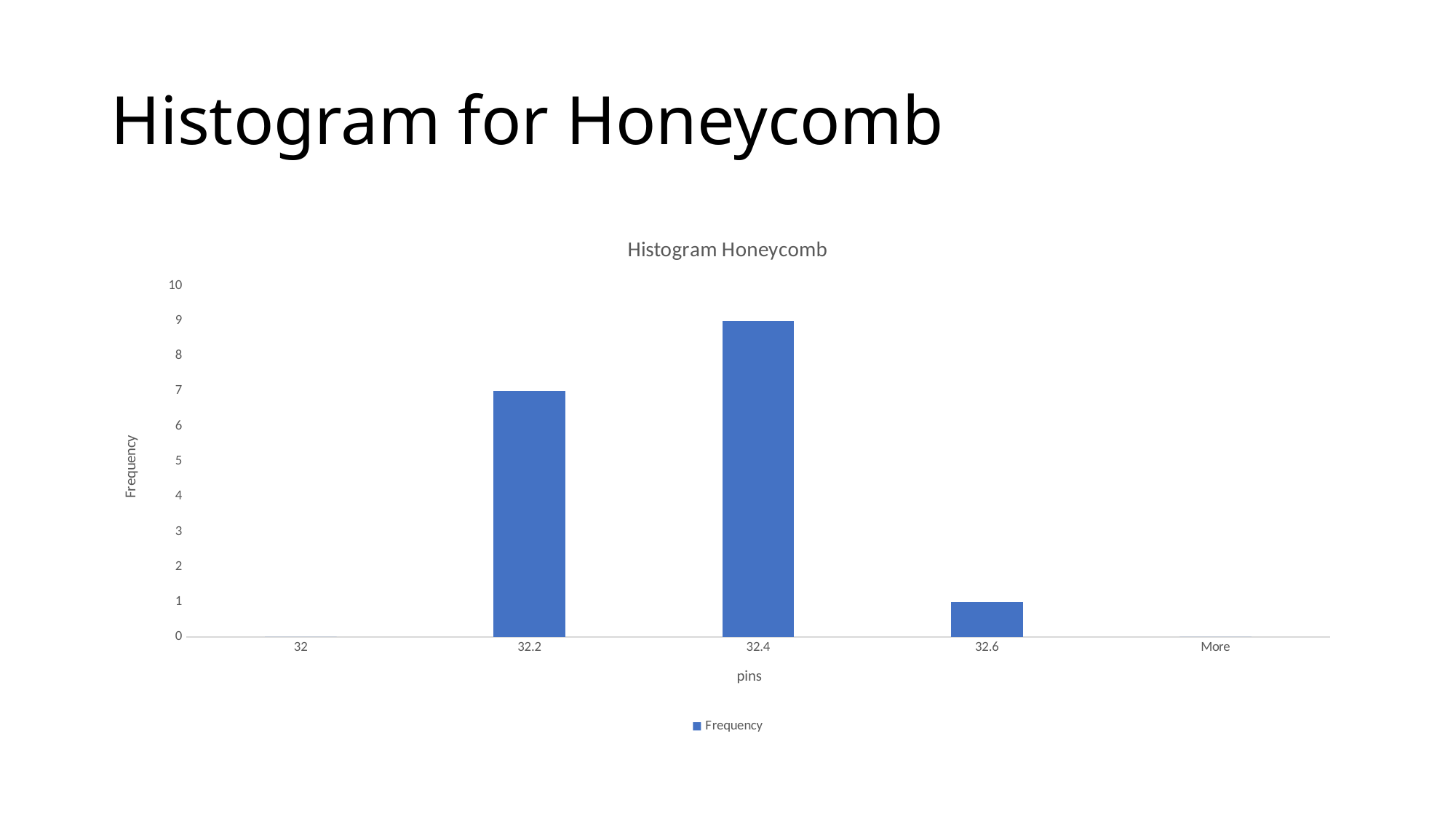
Which bin has a larger frequency, 32.2 or 32.6? 32.2 What is the frequency for the 32.6 bin? 1 Is the frequency for the 32.4 bin greater or less than 5? greater What is the difference in frequency between the 32.4 bin and the 32.2 bin? 2 How many bins are shown on the x axis? 5 Which bin has the highest frequency? 32.4 What kind of chart is shown on the slide? Bar chart What is the title of the chart? Histogram Honeycomb Which bin has the lowest non-zero frequency? 32.6 How many series does the legend list? 1 What is the frequency for the 32.4 bin? 9 What is the frequency for the 32.2 bin? 7